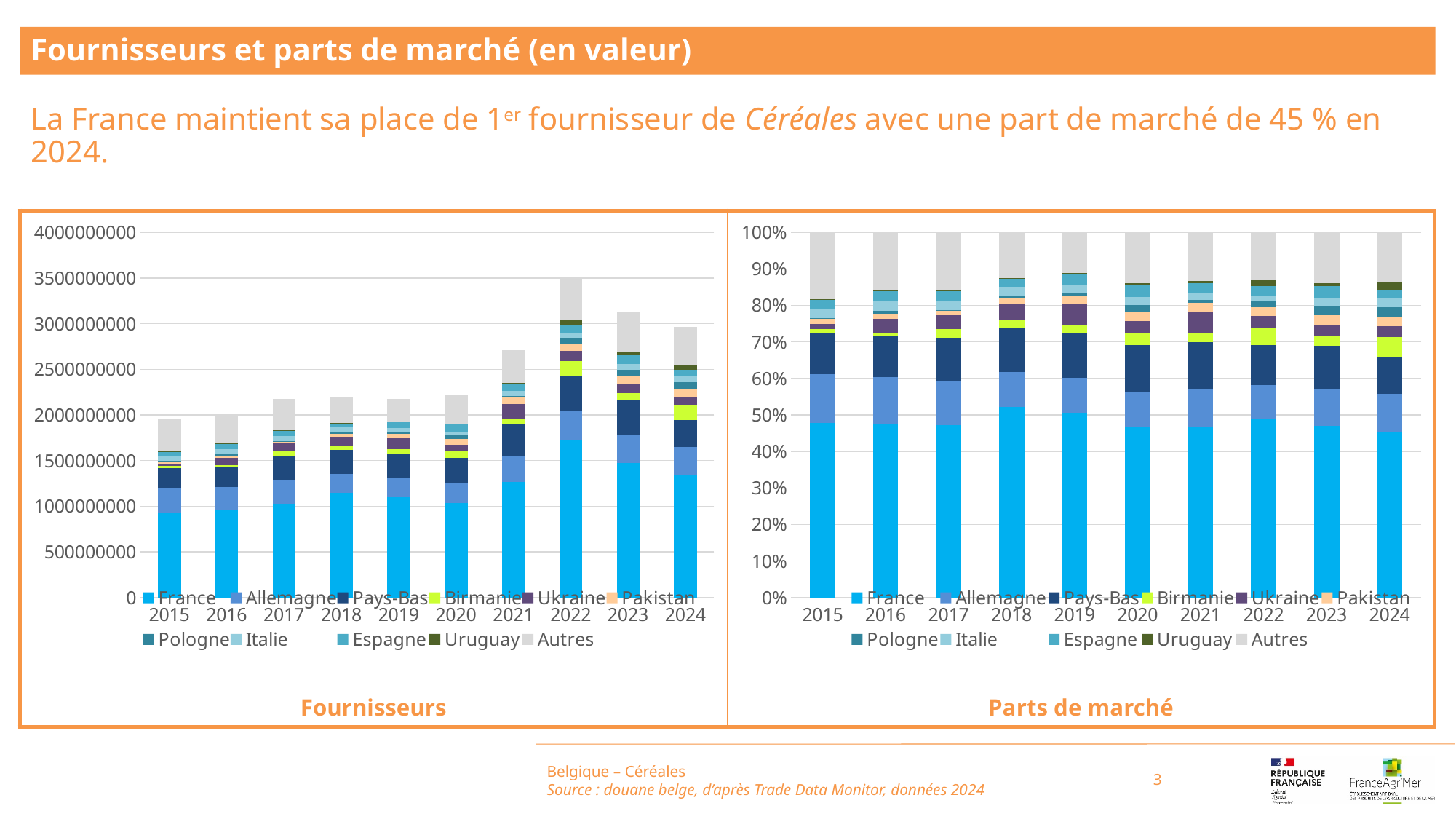
In the "Parts de marché" chart, is the France share larger in 2018 or in 2024? 2018 How many series does the legend of the "Fournisseurs" chart list? 11 In the "Fournisseurs" chart, is the total bar for 2017 greater or less than 2000000000? greater In the "Fournisseurs" chart, is the total bar for 2021 greater or less than 2500000000? greater In the "Fournisseurs" chart, is the France segment for 2022 greater or less than 1500000000? greater Which series is listed first in the legend of the "Parts de marché" chart? France In the "Fournisseurs" chart, which year has the tallest total bar? 2022 What kind of chart is the "Fournisseurs" chart on the left? stacked bar chart How many years are shown on the x axis of the "Parts de marché" chart? 10 In the "Fournisseurs" chart, is the total bar larger in 2022 or in 2023? 2022